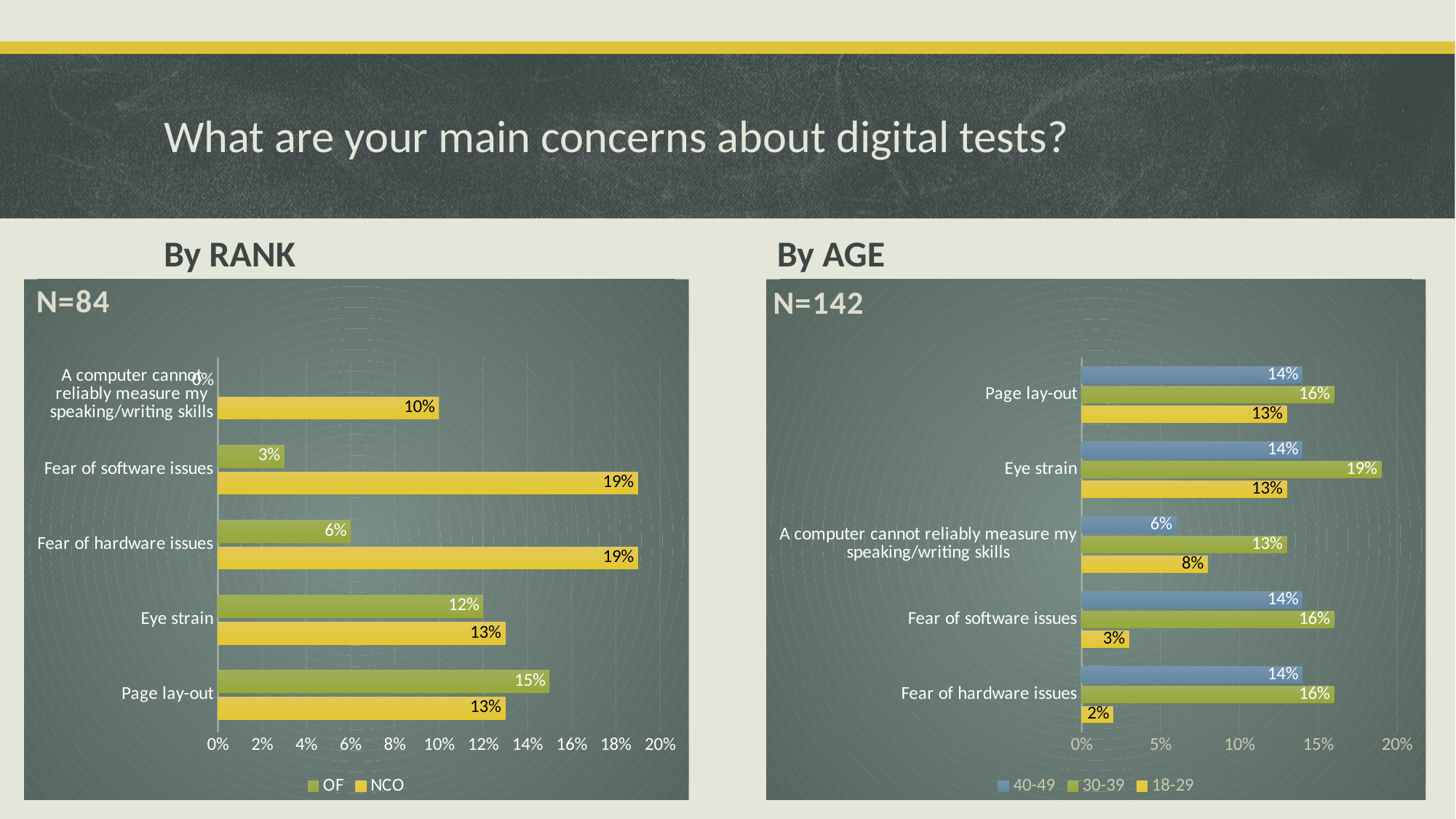
In the By AGE chart, which category has the lowest 40-49 value? A computer cannot reliably measure my speaking/writing skills In the By RANK chart, which is larger for Eye strain, the OF value or the NCO value? NCO In the By RANK chart, which category has the highest OF value? Page lay-out In the By RANK chart, what is the NCO value for Fear of software issues? 19% In the By AGE chart, what is the difference between the 30-39 and 18-29 values for Fear of software issues? 13% What type of chart is the By AGE chart? Bar chart In the By AGE chart, what is the 30-39 value for Eye strain? 19% In the By RANK chart, what is the OF value for Page lay-out? 15% In the By AGE chart, what is the 18-29 value for Fear of hardware issues? 2% In the By RANK chart, what is the difference between the NCO and OF values for Fear of hardware issues? 13% In the By AGE chart, how many categories are shown? 5 In the By RANK chart, how many series does the legend list? 2